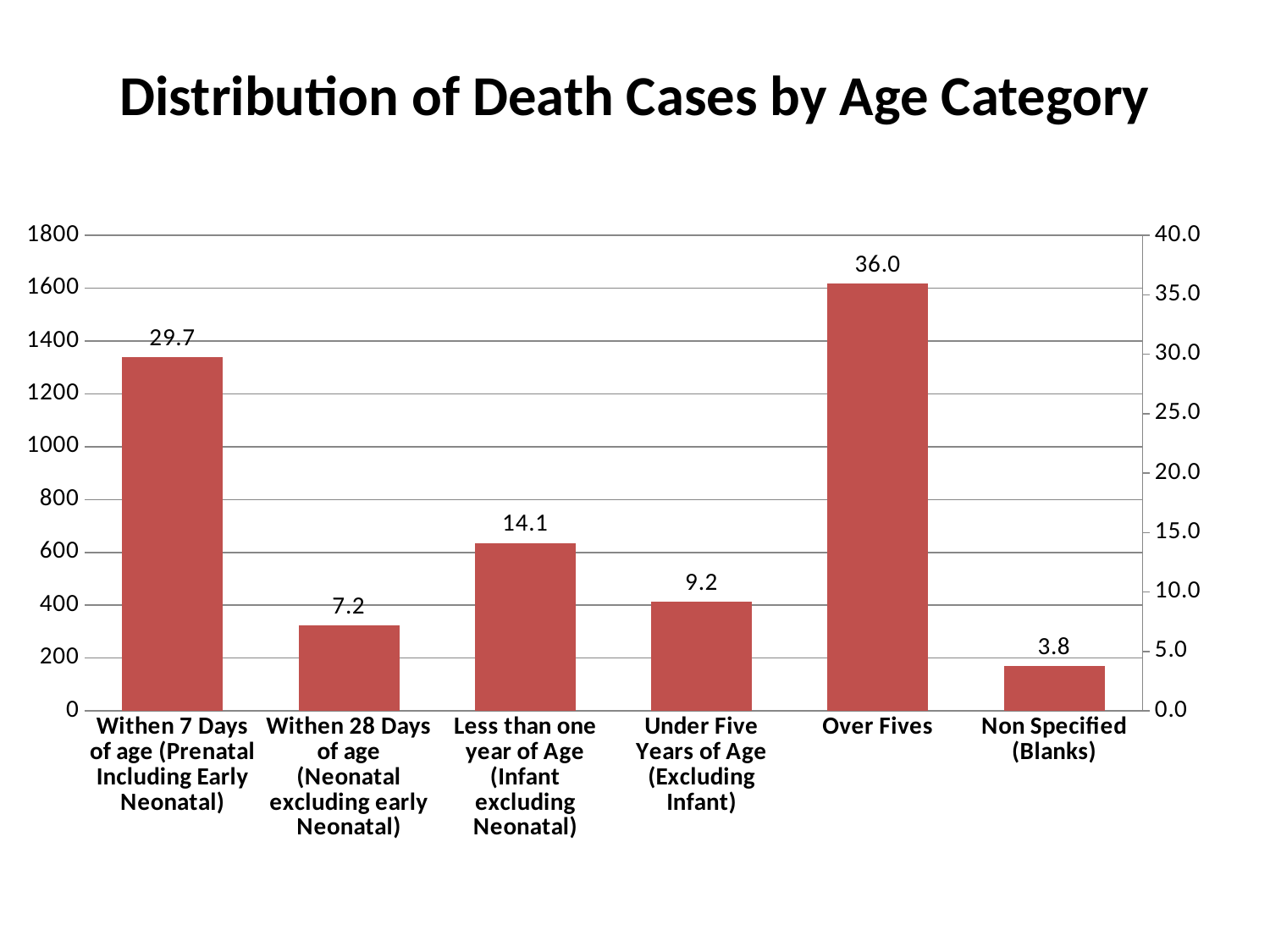
What is the data label on the bar for Non Specified (Blanks)? 3.8 Which age category has the lowest bar? Non Specified (Blanks) What is the data label on the bar for Under Five Years of Age (Excluding Infant)? 9.2 On the left axis, is the bar for Over Fives greater or less than 1400? greater What is the data label on the bar for Within 7 Days of age (Prenatal Including Early Neonatal)? 29.7 What type of chart is shown on the slide? Bar chart How many age categories are shown on the chart? 6 What is the data label on the bar for Over Fives? 36.0 Which is larger: the value for Less than one year of Age (Infant excluding Neonatal) or the value for Within 28 Days of age (Neonatal excluding early Neonatal)? Less than one year of Age (Infant excluding Neonatal) On the left axis, is the bar for Non Specified (Blanks) greater or less than 400? less Which age category has the highest bar? Over Fives What is the difference between the data labels for Over Fives and Within 7 Days of age (Prenatal Including Early Neonatal)? 6.3